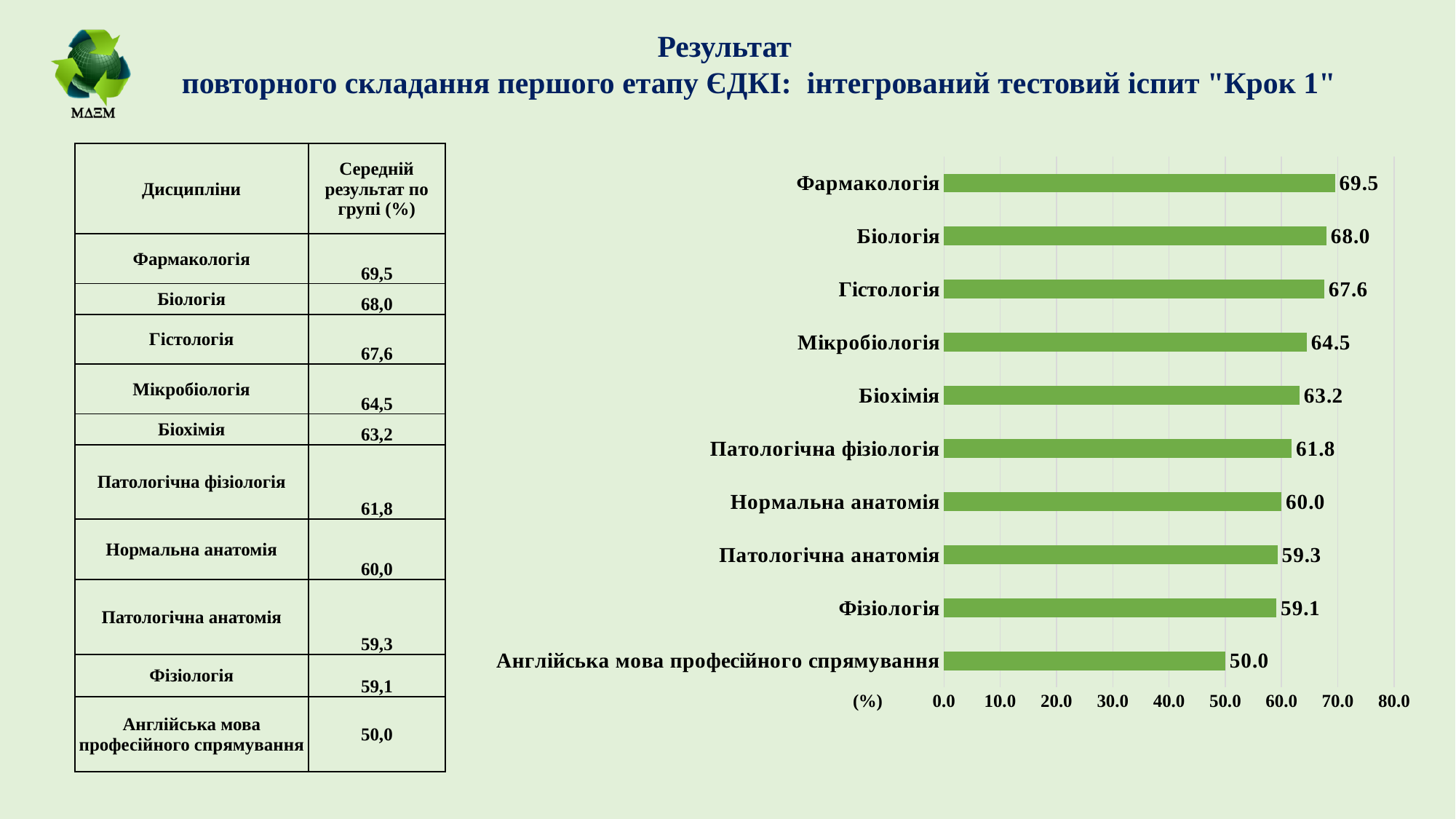
Which has a larger value in the bar chart, Гістологія or Біохімія? Гістологія Which discipline has the lowest value in the bar chart? Англійська мова професійного спрямування What is the value for Фармакологія in the bar chart? 69.5 What is the difference between the values for Фармакологія and Біологія in the bar chart? 1.5 What is the value for Англійська мова професійного спрямування in the bar chart? 50.0 What kind of chart is shown on the slide? bar chart Which discipline has the highest value in the bar chart? Фармакологія What is the difference between the values for Нормальна анатомія and Англійська мова професійного спрямування in the bar chart? 10.0 What is the value for Мікробіологія in the bar chart? 64.5 What colour are the bars in the chart? green Is the value for Патологічна фізіологія in the bar chart greater or less than 70.0? less How many disciplines are shown in the bar chart? 10